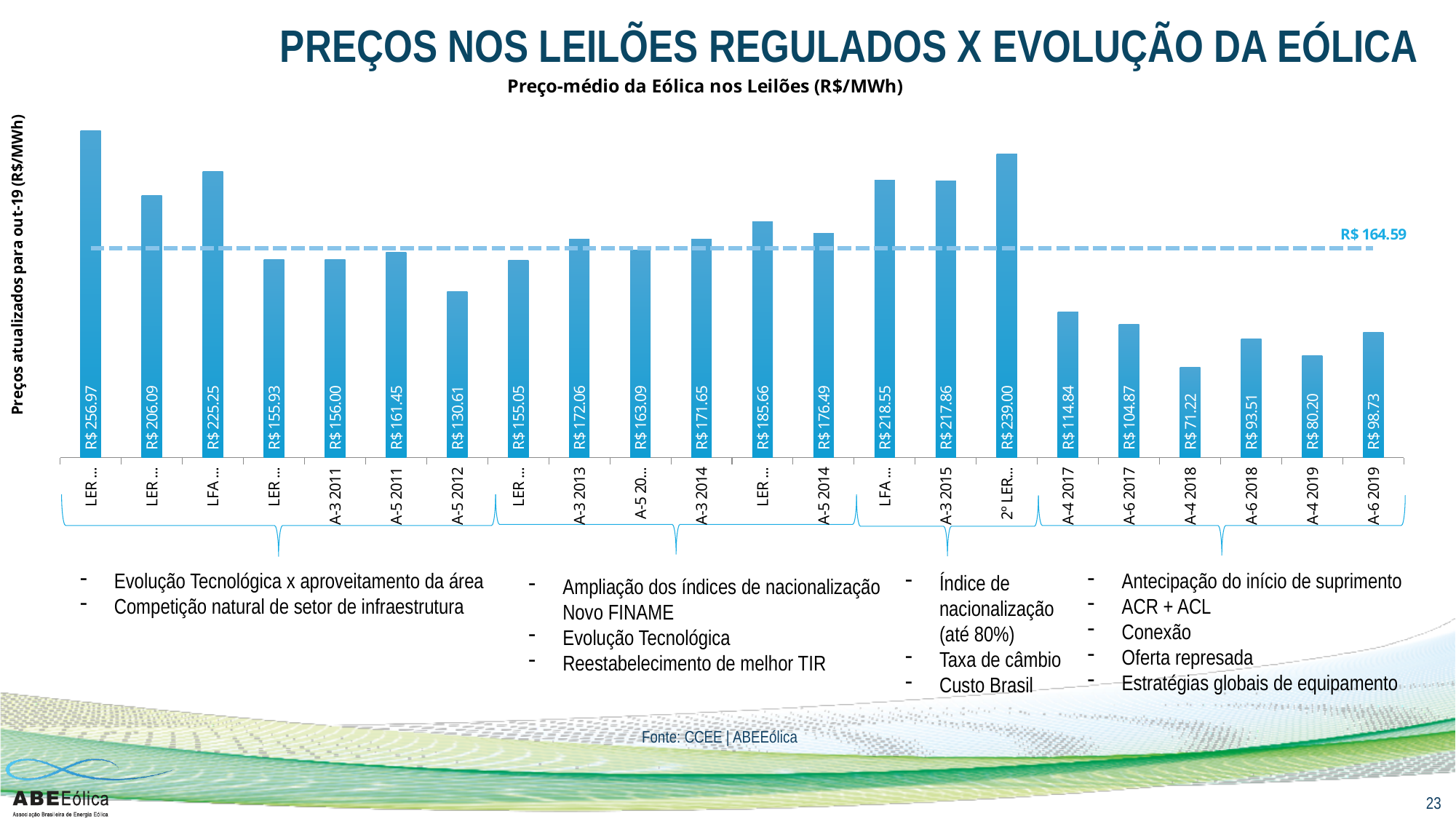
How many bars are shown on the chart? 22 What kind of chart is shown on the slide? Bar chart What is the value for A-3 2015? R$ 217.86 Which labelled auction has the lowest average price? A-4 2018 What is the value for A-5 2012? R$ 130.61 What is the value for A-6 2019? R$ 98.73 What is the highest value shown on the chart? R$ 256.97 What value does the dashed horizontal line represent? R$ 164.59 What is the value for A-4 2018? R$ 71.22 Which is larger, the value for A-5 2014 or the value for A-6 2017? A-5 2014 What is the difference between the values for A-5 2011 and A-3 2011? R$ 5.45 What is the difference between the values for A-6 2018 and A-4 2018? R$ 22.29